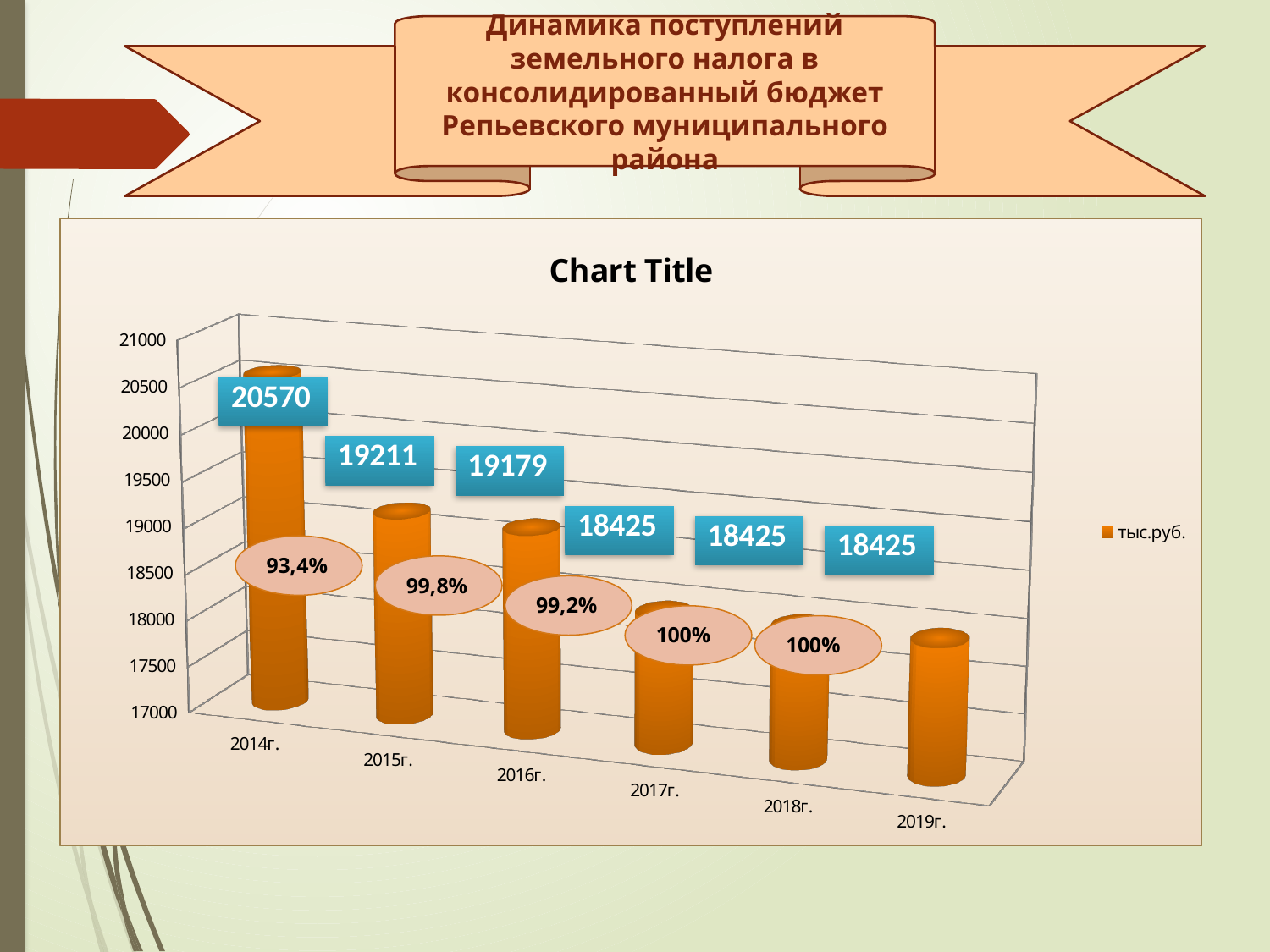
Which year has the highest value? 2014г. What kind of chart is shown? bar chart How many series does the legend list? 1 Which is larger, the value for 2015г. or the value for 2016г.? 2015г. What is the value for 2014г.? 20570 Do the values rise or fall from 2014г. to 2017г.? fall What is the difference between the values for 2014г. and 2015г.? 1359 What is the legend entry of the chart? тыс.руб. How many years are shown on the x axis? 6 What is the difference between the values for 2016г. and 2017г.? 754 What is the value for 2018г.? 18425 What is the value for 2016г.? 19179